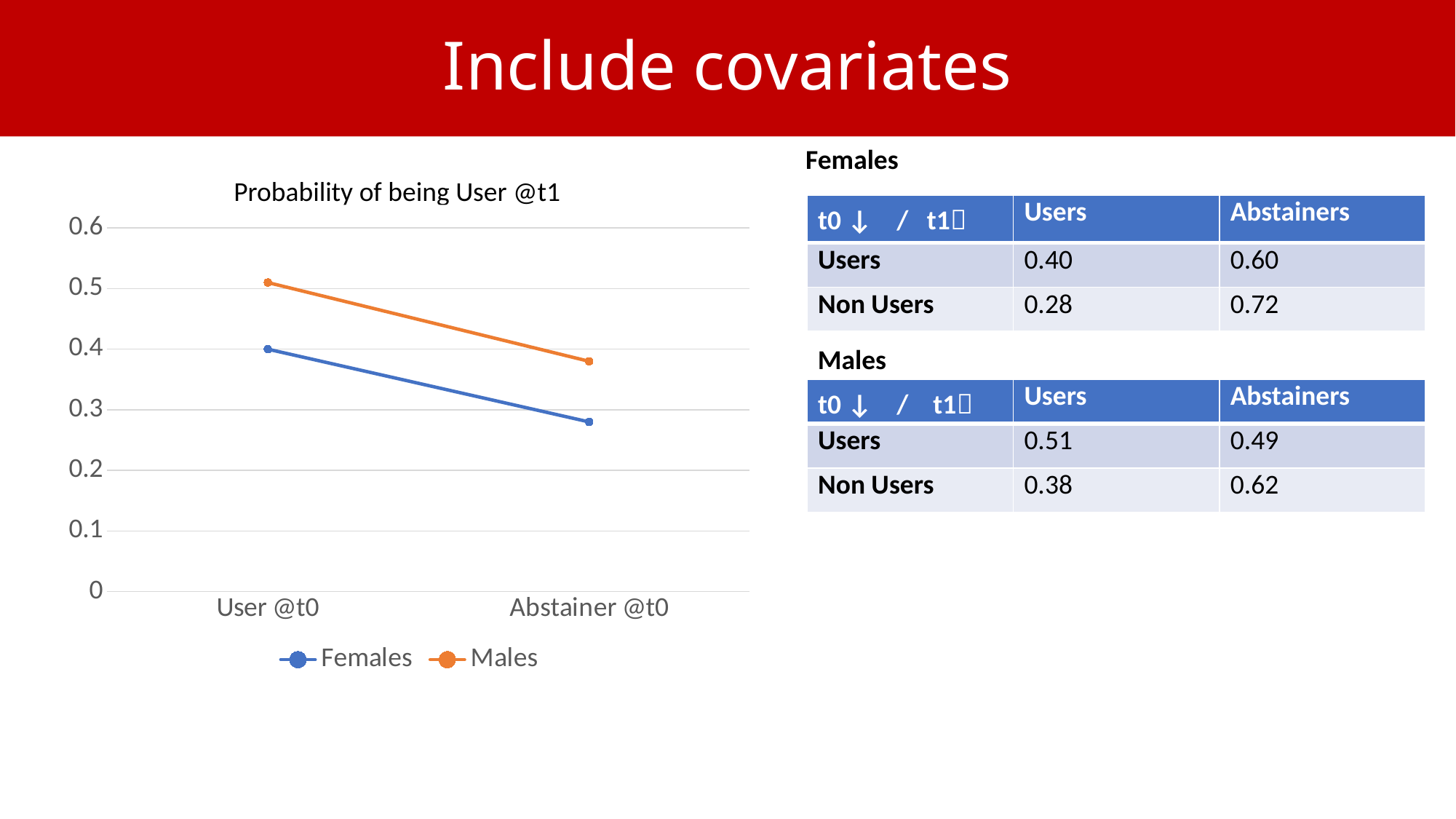
Is the value for Males at Abstainer @t0 greater or less than 0.3? greater Do the values for Females rise or fall from User @t0 to Abstainer @t0? fall Is the value for Males at User @t0 greater or less than 0.4? greater How many series does the chart's legend list? 2 Which colour is used for the Females series in the chart? blue What kind of chart is shown on the slide? line chart At Abstainer @t0, which series has the larger value, Females or Males? Males What is the value for Females at User @t0? 0.4 Do the values for Males rise or fall from User @t0 to Abstainer @t0? fall What is the title of the chart? Probability of being User @t1 At User @t0, which series has the larger value, Females or Males? Males How many categories are shown on the x axis of the chart? 2